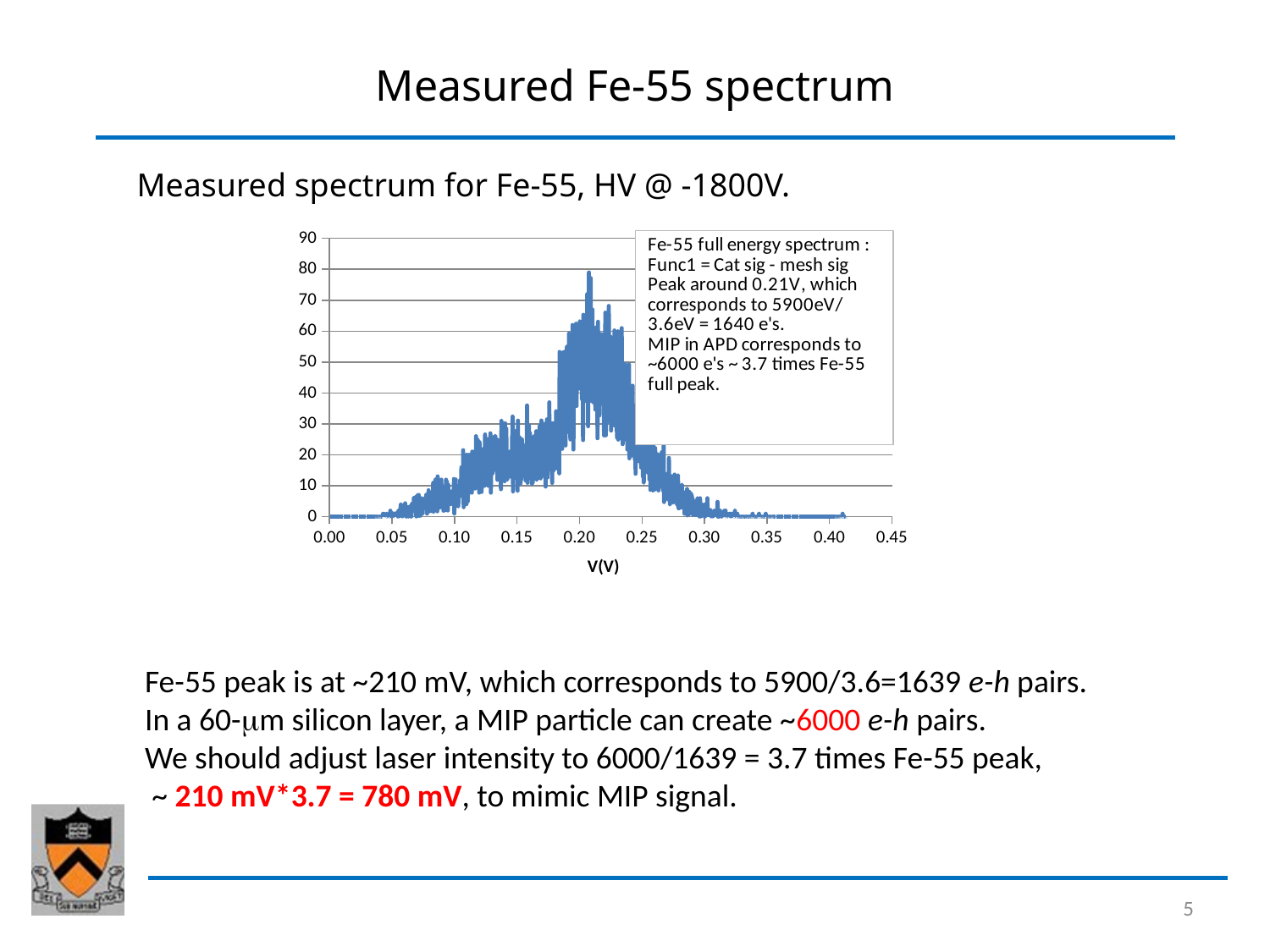
Do the values of the spectrum rise or fall between 0.05 V and 0.20 V on the x axis? rise According to the text box in the chart, around what voltage is the Fe-55 peak? 0.21V Is the peak value of the spectrum greater or less than 70? greater What is the highest tick value shown on the x axis of the chart? 0.45 Is the value of the spectrum at 0.10 V greater or less than 30? less What is the highest tick value shown on the y axis of the chart? 90 What is the label of the x axis of the chart? V(V) Is the value of the spectrum at 0.40 V greater or less than 10? less Do the values of the spectrum rise or fall between 0.25 V and 0.35 V on the x axis? fall What kind of chart is shown on the slide? line chart